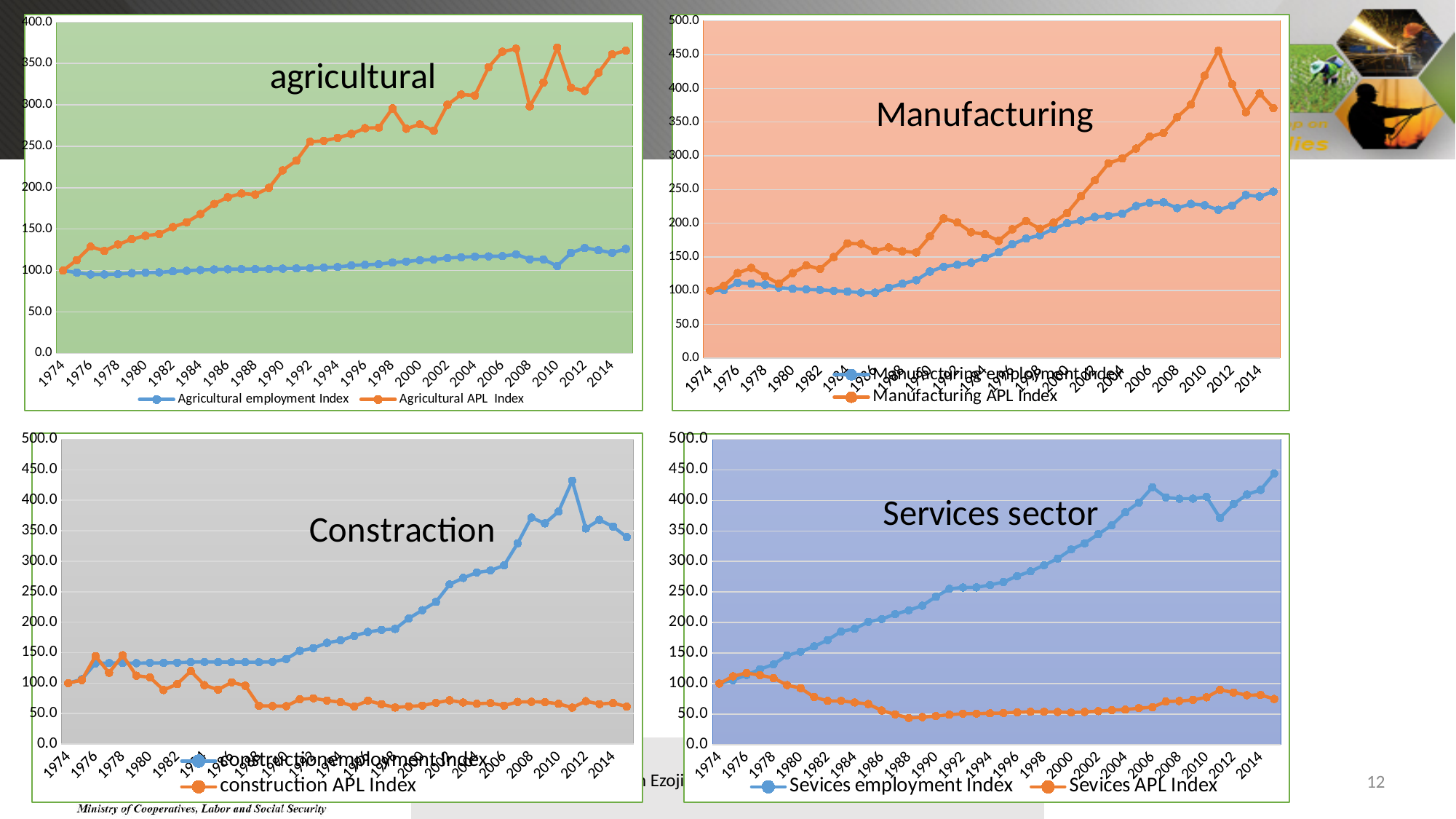
In the 'Manufacturing' chart, which series is higher in 2014, the Manufacturing APL Index or the Manufacturing employment Index? Manufacturing APL Index In the 'agricultural' chart, is the value of the Agricultural employment Index in 2014 greater or less than 150? less In the 'agricultural' chart, which colour is used for the Agricultural APL Index line? orange In the 'Services sector' chart, does the Sevices employment Index generally rise or fall from 1974 to 2014? rise In the 'Services sector' chart, does the Sevices APL Index rise or fall between 1978 and 1988? fall In the 'Constraction' chart, which series is higher in 2014, the construction employment Index or the construction APL Index? construction employment Index How many charts are shown on the slide? 4 How many series does the legend of the 'Services sector' chart list? 2 What kind of chart is the 'agricultural' chart? line chart In the 'agricultural' chart, is the value of the Agricultural APL Index in 2014 greater or less than 300? greater In the 'Manufacturing' chart, is the value of the Manufacturing APL Index in 2011 greater or less than 400? greater